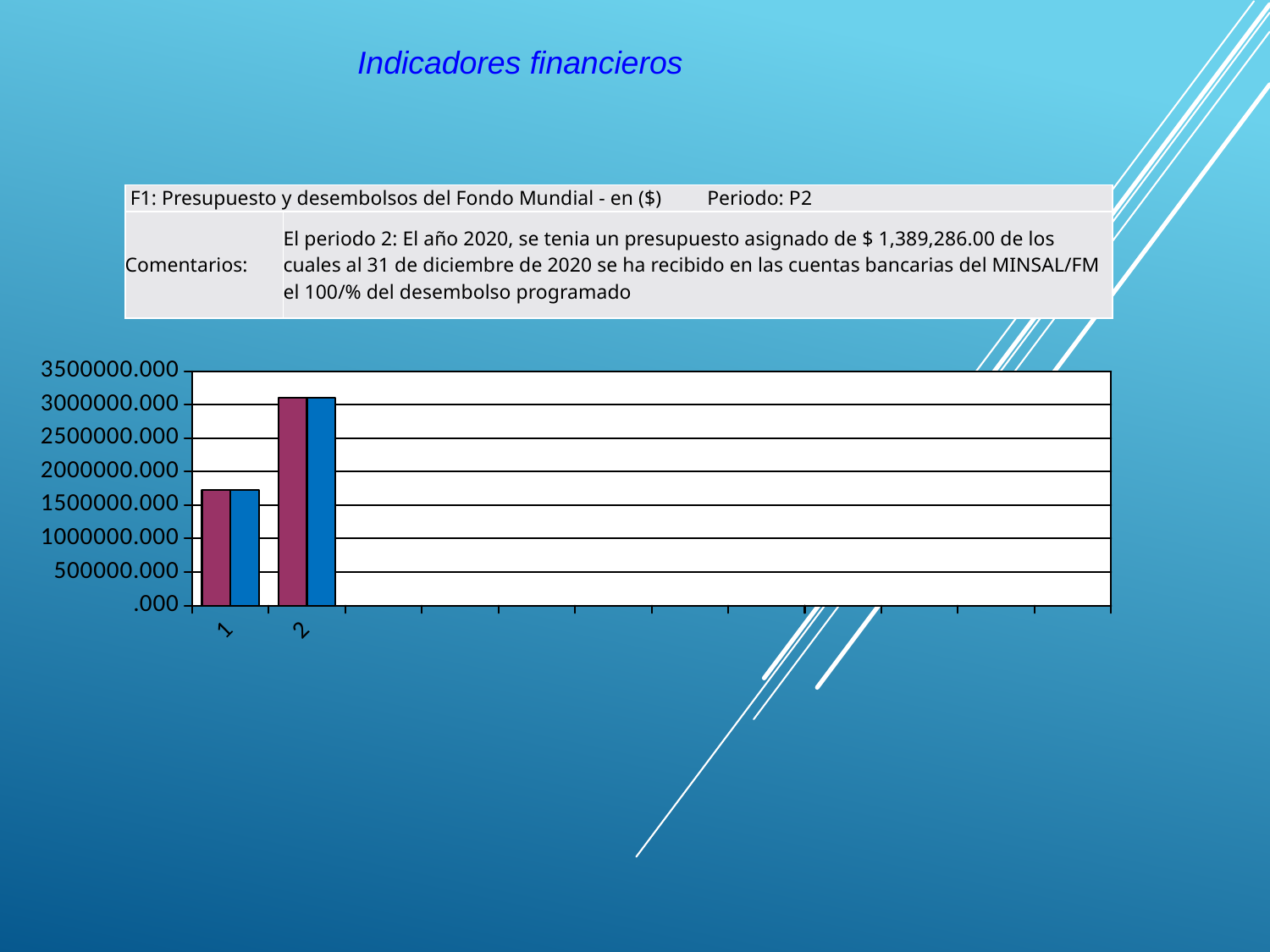
How many bars are drawn for each category in the chart? 2 Do the bar values rise or fall from category 1 to category 2? rise Is the value of the blue bar for category 1 greater or less than 2000000.000? less How many categories are labelled on the x axis of the chart? 2 Which category has the shortest bars in the chart? 1 Which category has the tallest bars in the chart? 2 Is the value of the purple bar for category 2 greater or less than 2500000.000? greater What is the highest tick value shown on the y axis of the chart? 3500000.000 Is the value of the purple bar for category 1 greater or less than 1500000.000? greater What kind of chart is shown on the slide? bar chart Are the bars for category 2 taller or shorter than the bars for category 1? taller